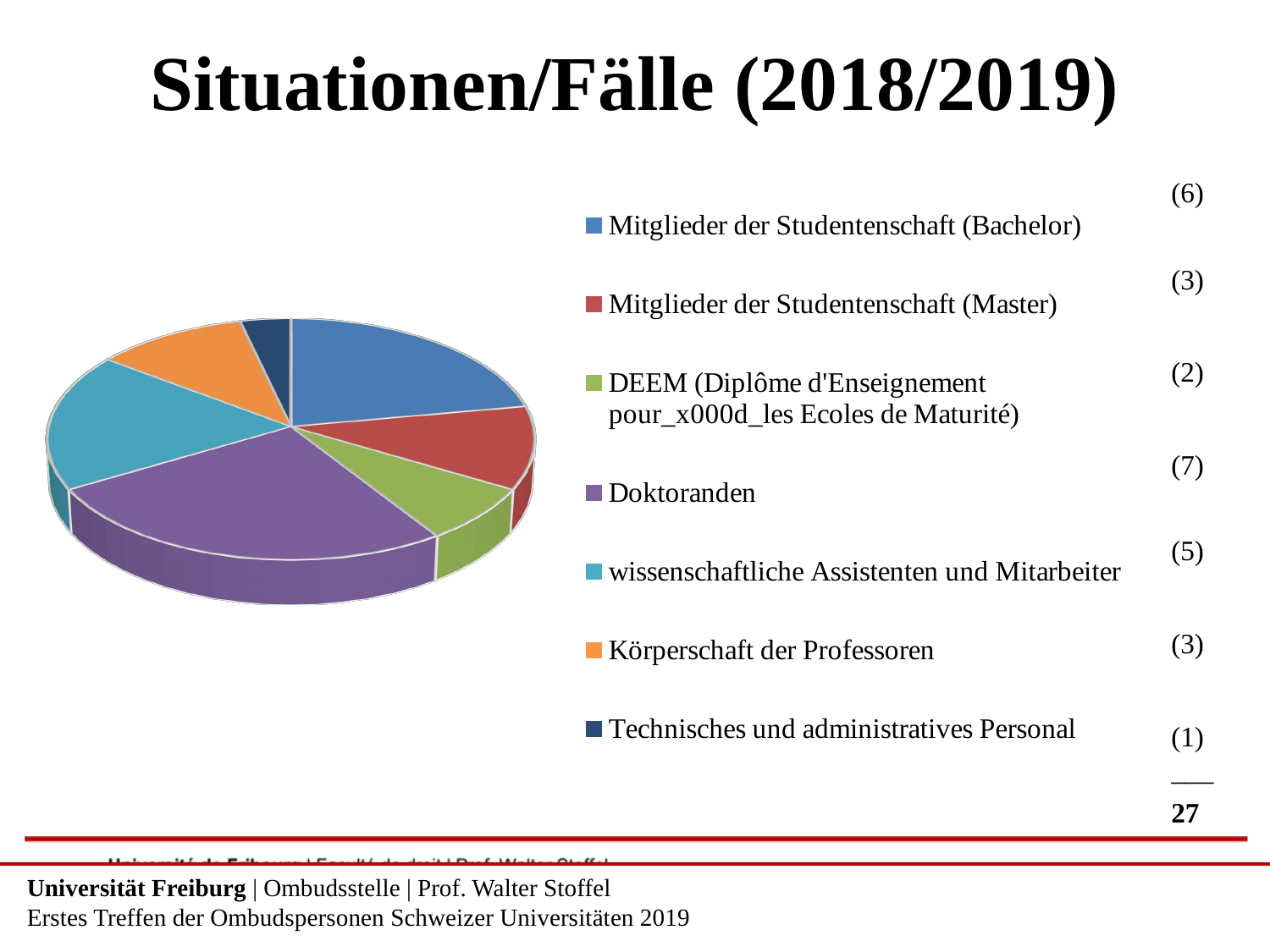
Which has more cases: wissenschaftliche Assistenten und Mitarbeiter or Körperschaft der Professoren? wissenschaftliche Assistenten und Mitarbeiter What kind of chart is shown on the slide? pie chart How many cases are listed for Mitglieder der Studentenschaft (Master)? 3 What colour is the Doktoranden slice in the pie chart? purple How many cases are listed for DEEM (Diplôme d'Enseignement pour les Ecoles de Maturité)? 2 How many cases are listed for Doktoranden? 7 How many categories does the pie chart have? 7 What is the total number of cases shown on the slide? 27 How many cases are listed for Mitglieder der Studentenschaft (Bachelor)? 6 What is the difference between the number of cases for Doktoranden and for Mitglieder der Studentenschaft (Bachelor)? 1 Which category has the smallest number of cases? Technisches und administratives Personal Which category has the largest number of cases? Doktoranden